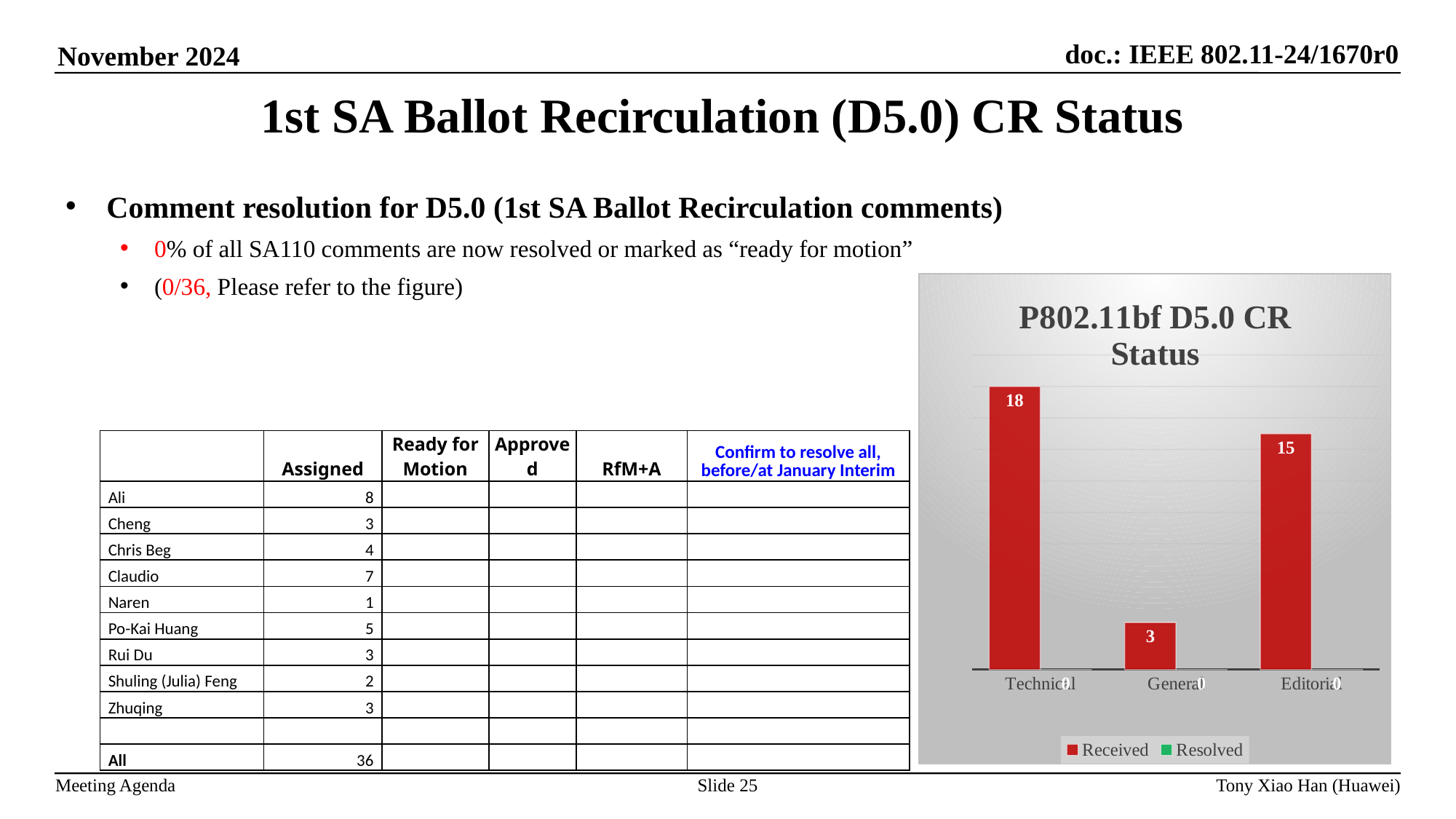
What kind of chart is shown on the slide? bar chart Which category has the highest Received value? Technical Which has a larger Received value, General or Editorial? Editorial How many categories are shown on the x axis of the chart? 3 What is the title of the chart on the slide? P802.11bf D5.0 CR Status What is the Received value for General? 3 What are the two series listed in the chart legend? Received and Resolved What is the Received value for Technical? 18 What is the difference between the Received values for Technical and Editorial? 3 What is the Received value for Editorial? 15 Which category has the lowest Received value? General How many series does the chart legend list? 2